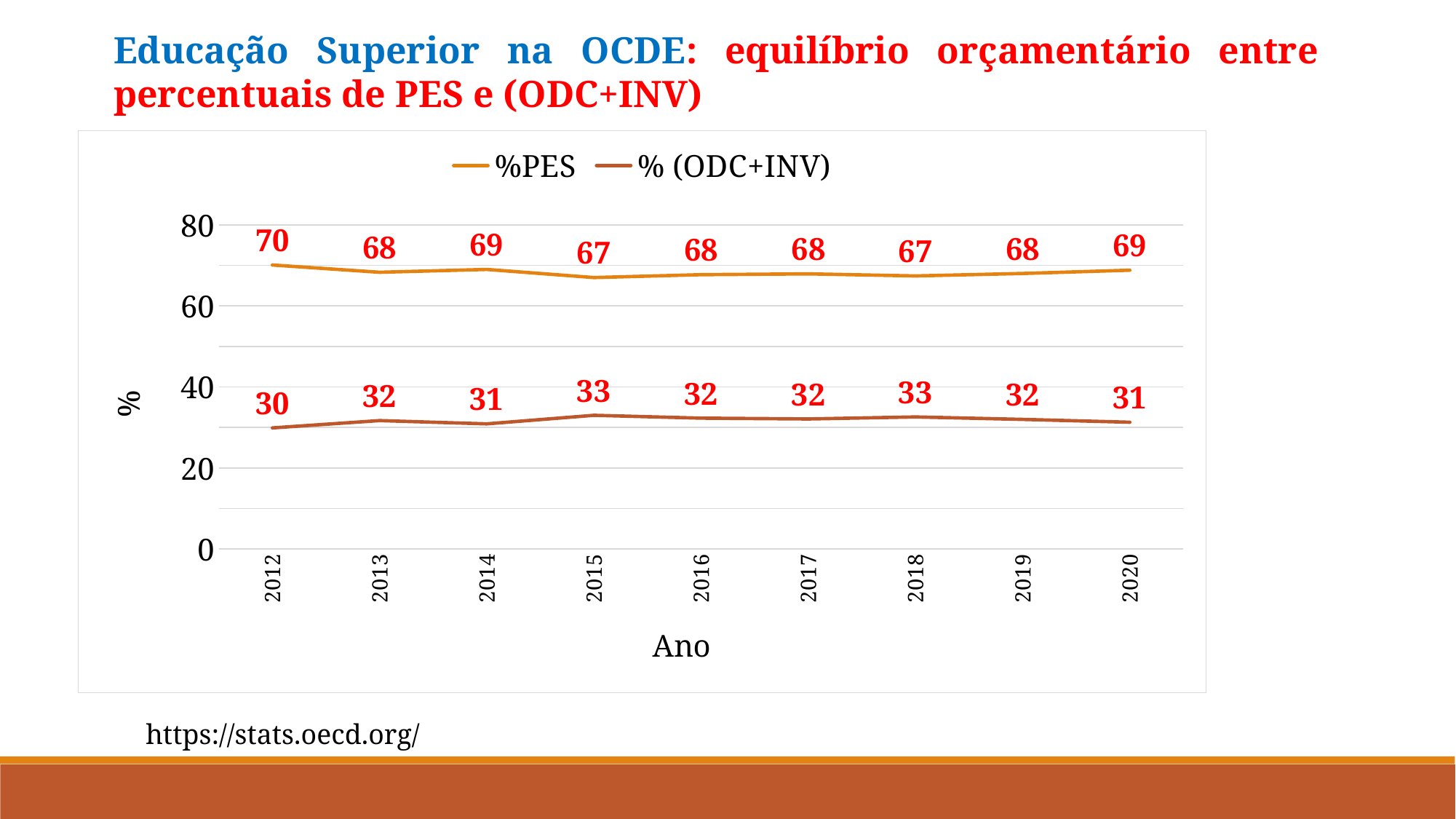
What kind of chart is shown on the slide? line chart What is the %PES value for 2012? 70 Is the % (ODC+INV) value for 2016 greater or less than 40? less In which year is % (ODC+INV) lowest? 2012 In which year is %PES highest? 2012 What is the difference between %PES and % (ODC+INV) in 2012? 40 How many series does the legend list? 2 What is the % (ODC+INV) value for 2015? 33 What is the label of the x axis? Ano Which series has the larger value in 2018, %PES or % (ODC+INV)? %PES How many years are shown on the x axis? 9 What is the %PES value for 2020? 69